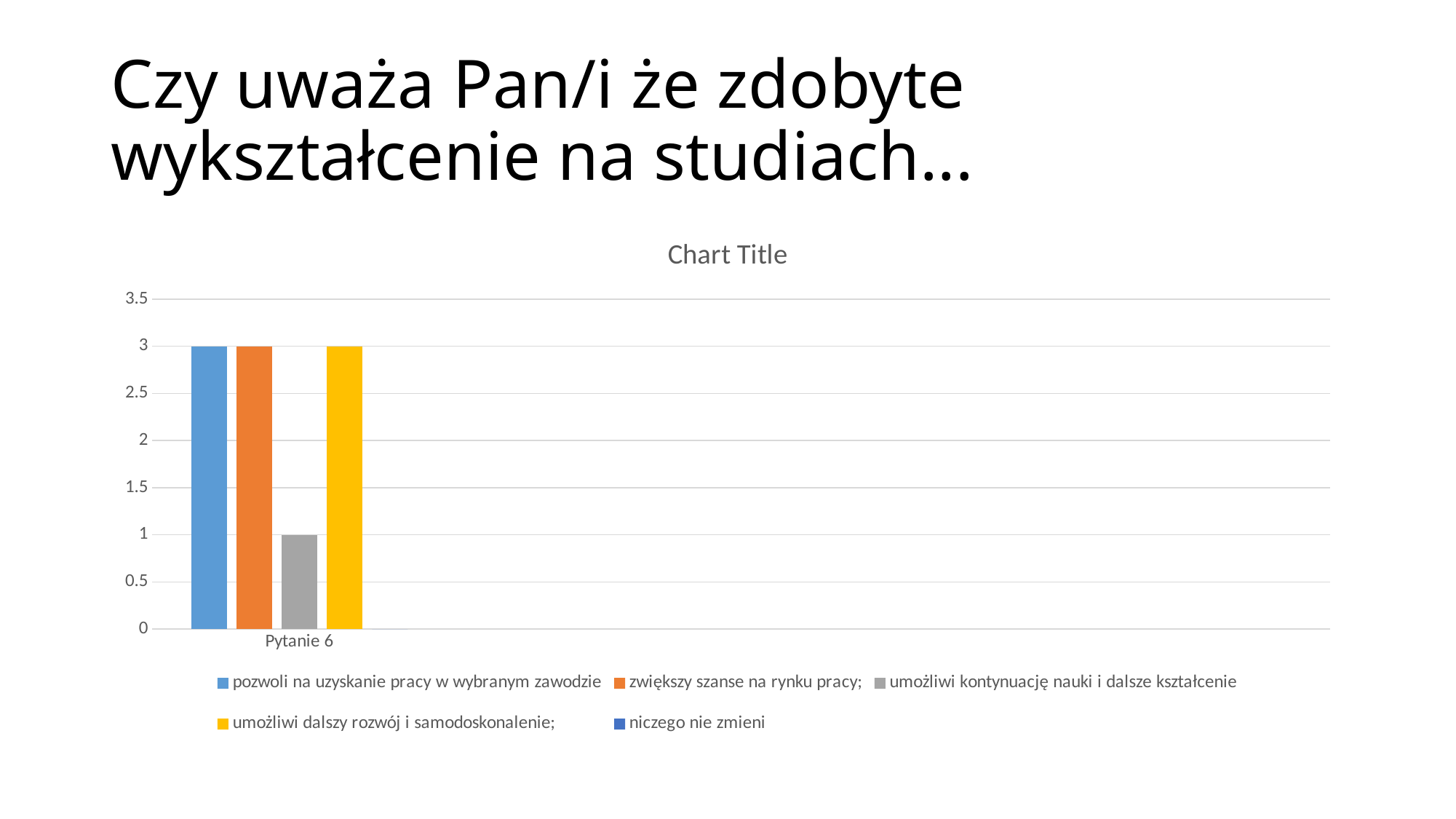
What is the value for 'pozwoli na uzyskanie pracy w wybranym zawodzie'? 3 Which is larger: the value for 'umożliwi dalszy rozwój i samodoskonalenie;' or the value for 'umożliwi kontynuację nauki i dalsze kształcenie'? umożliwi dalszy rozwój i samodoskonalenie; Which series has the lowest visible bar? umożliwi kontynuację nauki i dalsze kształcenie What kind of chart is shown on the slide? bar chart How many series does the legend list? 5 Is the value for 'umożliwi kontynuację nauki i dalsze kształcenie' greater or less than 2? less What is the value for 'umożliwi dalszy rozwój i samodoskonalenie;'? 3 What is the category label on the x axis? Pytanie 6 How many categories are shown on the x axis? 1 What is the value for 'zwiększy szanse na rynku pracy;'? 3 What is the value for 'umożliwi kontynuację nauki i dalsze kształcenie'? 1 What is the difference between the value for 'pozwoli na uzyskanie pracy w wybranym zawodzie' and the value for 'umożliwi kontynuację nauki i dalsze kształcenie'? 2